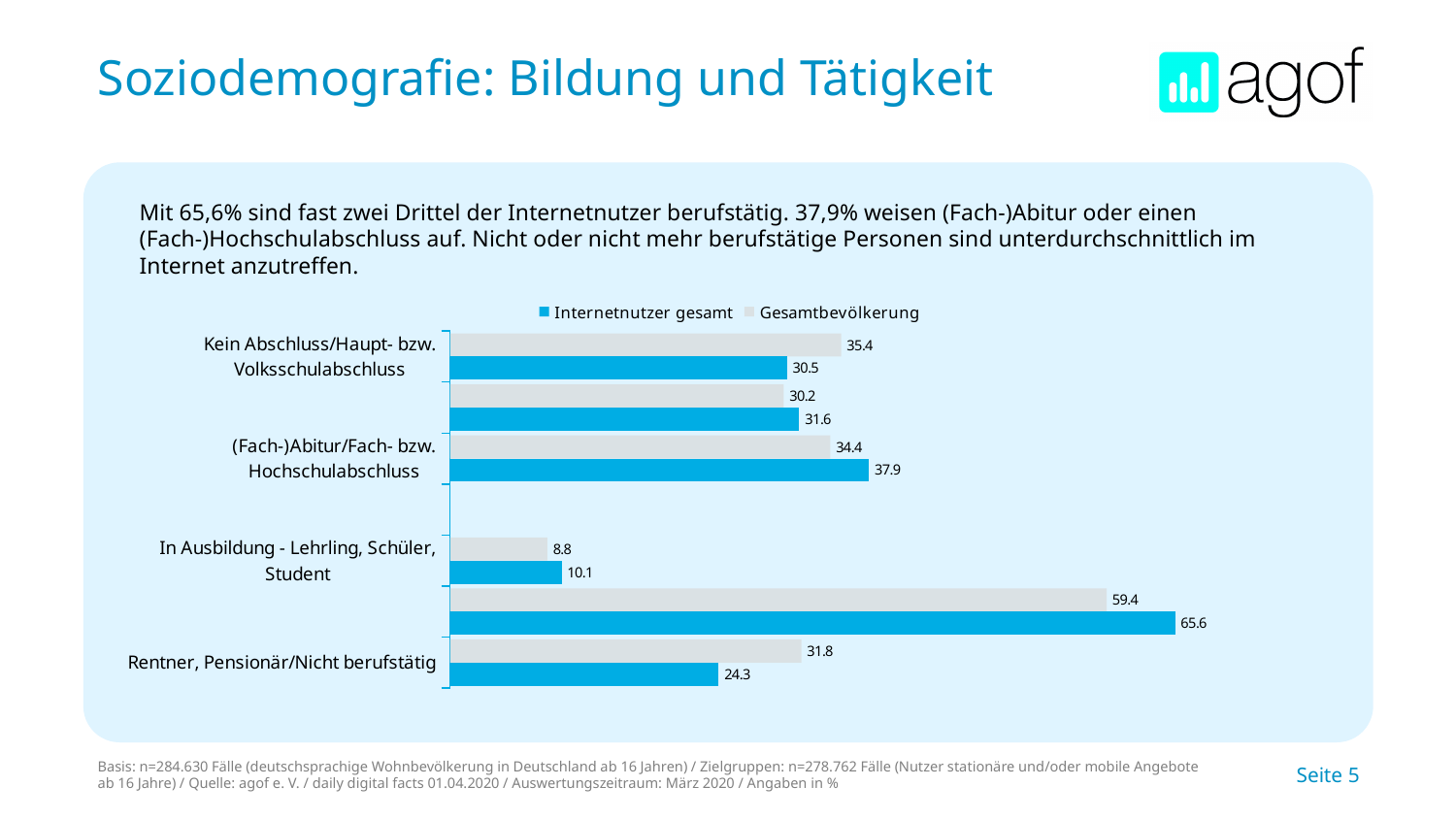
What is the value for Gesamtbevölkerung in the category Kein Abschluss/Haupt- bzw. Volksschulabschluss? 35.4 In the category Rentner, Pensionär/Nicht berufstätig, which series has the larger value, Internetnutzer gesamt or Gesamtbevölkerung? Gesamtbevölkerung How many series does the legend list? 2 Which colour represents the series Gesamtbevölkerung in the chart? Grey What is the value for Gesamtbevölkerung in the category (Fach-)Abitur/Fach- bzw. Hochschulabschluss? 34.4 What is the value for Internetnutzer gesamt in the category Rentner, Pensionär/Nicht berufstätig? 24.3 In the category In Ausbildung - Lehrling, Schüler, Student, which series has the larger value, Internetnutzer gesamt or Gesamtbevölkerung? Internetnutzer gesamt What is the difference between Gesamtbevölkerung and Internetnutzer gesamt in the category Rentner, Pensionär/Nicht berufstätig? 7.5 What is the value for Internetnutzer gesamt in the category In Ausbildung - Lehrling, Schüler, Student? 10.1 What is the difference between Internetnutzer gesamt and Gesamtbevölkerung in the category Kein Abschluss/Haupt- bzw. Volksschulabschluss? 4.9 What kind of chart is shown on the slide? Bar chart What is the value for Internetnutzer gesamt in the category (Fach-)Abitur/Fach- bzw. Hochschulabschluss? 37.9